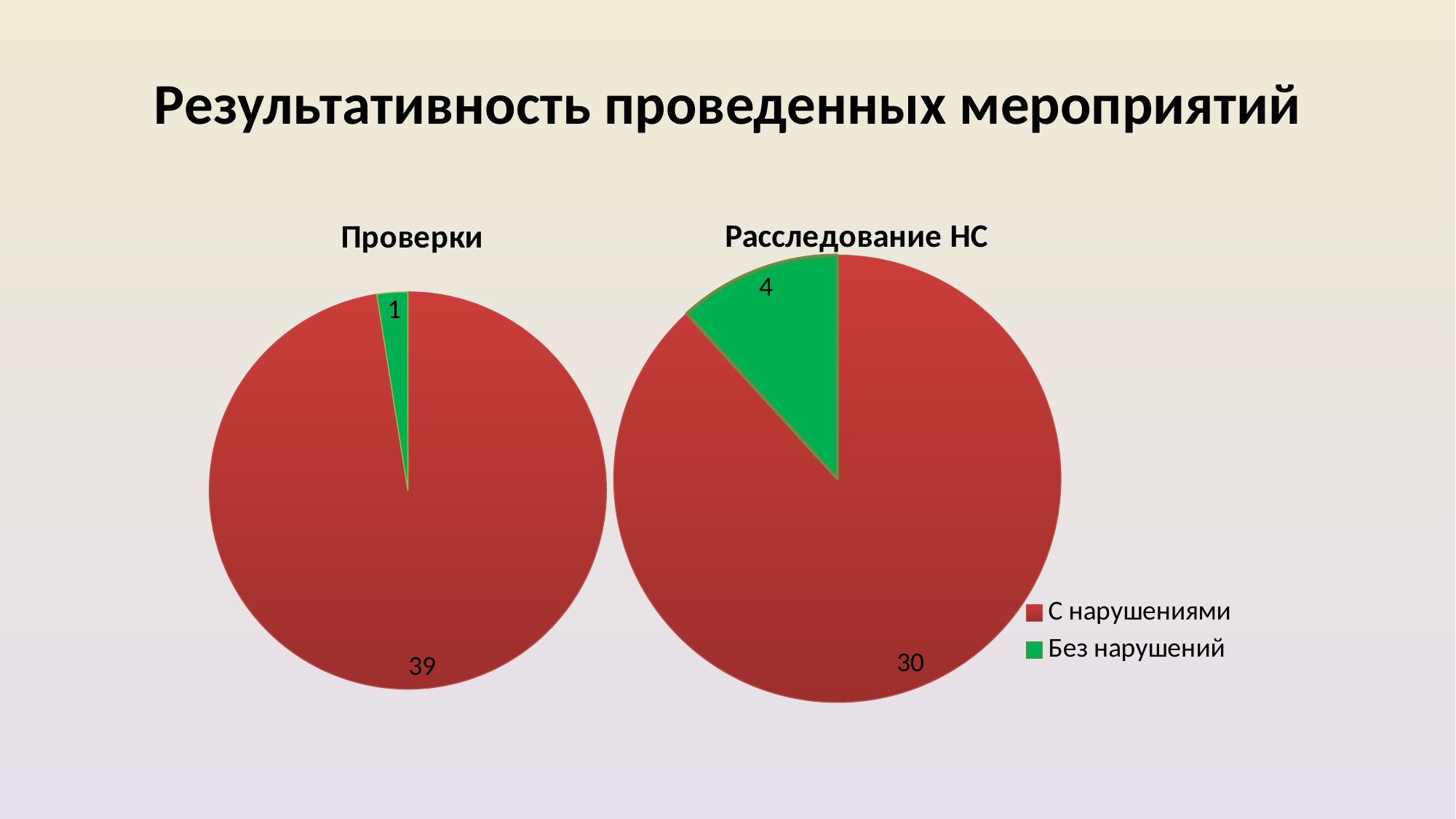
What type of chart is used for "Проверки" and "Расследование НС"? Pie chart In the "Проверки" chart, what is the value for "С нарушениями"? 39 How many entries does the legend list? 2 In the "Расследование НС" chart, what is the value for "С нарушениями"? 30 In the "Расследование НС" chart, what is the difference between "С нарушениями" and "Без нарушений"? 26 In the "Проверки" chart, what is the value for "Без нарушений"? 1 Which is larger: "Без нарушений" in the "Проверки" chart or "Без нарушений" in the "Расследование НС" chart? Расследование НС In the "Расследование НС" chart, which category has the smallest slice? Без нарушений In the "Проверки" chart, which category has the largest slice? С нарушениями In the "Проверки" chart, what share of the total does "Без нарушений" represent? 2.5% In the "Расследование НС" chart, what is the value for "Без нарушений"? 4 In the "Проверки" chart, what is the difference between "С нарушениями" and "Без нарушений"? 38